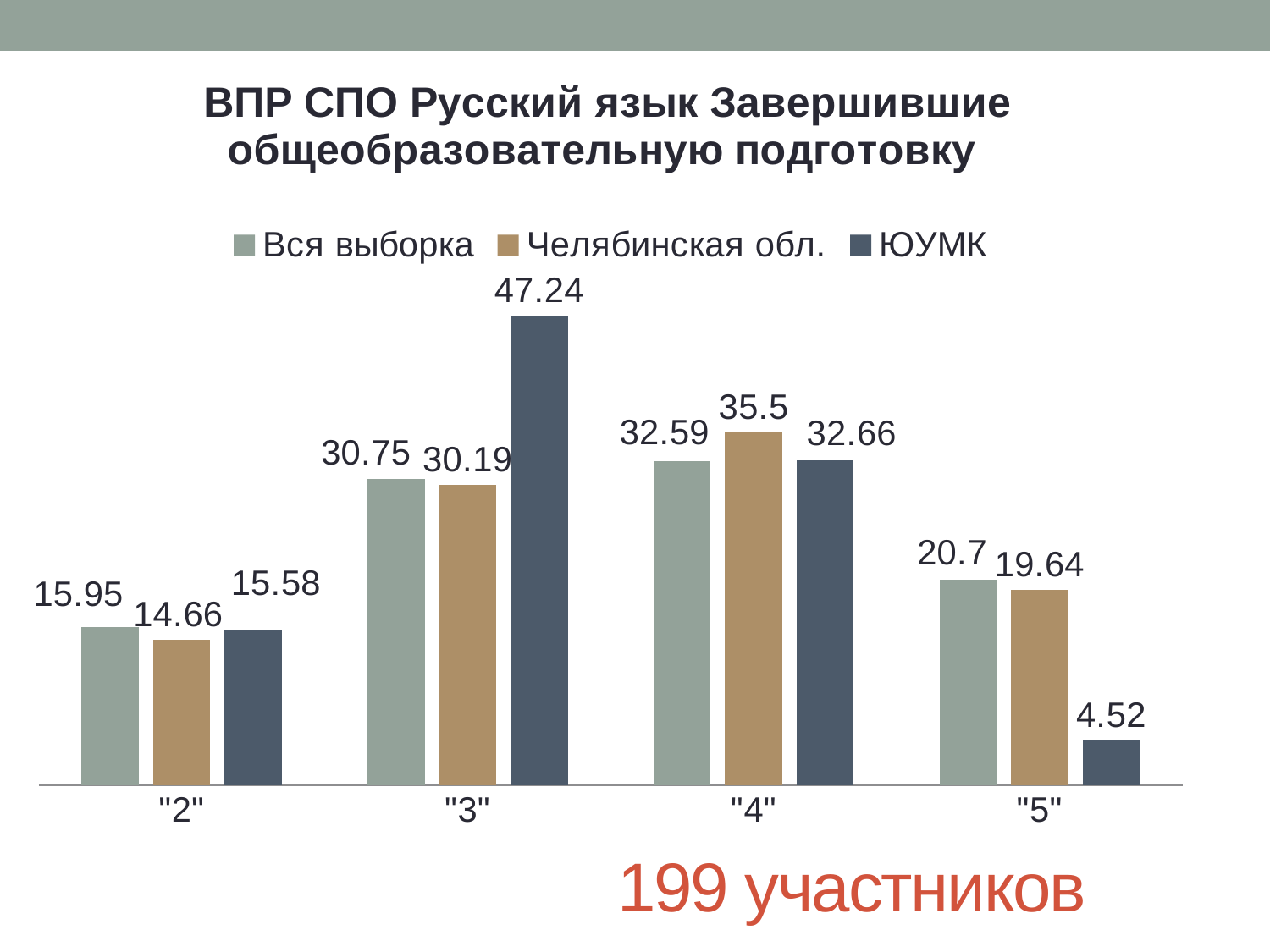
What is the difference between the Челябинская обл. value and the Вся выборка value in category "2"? 1.29 What is the value for ЮУМК in category "3"? 47.24 How many series does the legend list? 3 How many categories are shown on the x axis? 4 What number of participants is stated below the chart? 199 участников What is the value for Вся выборка in category "5"? 20.7 Which category has the highest value for Вся выборка? "4" What is the value for Челябинская обл. in category "4"? 35.5 What kind of chart is shown on the slide? bar chart What is the difference between the ЮУМК value and the Вся выборка value in category "3"? 16.49 Which category has the lowest value for ЮУМК? "5" In category "5", which is larger: Челябинская обл. or ЮУМК? Челябинская обл.